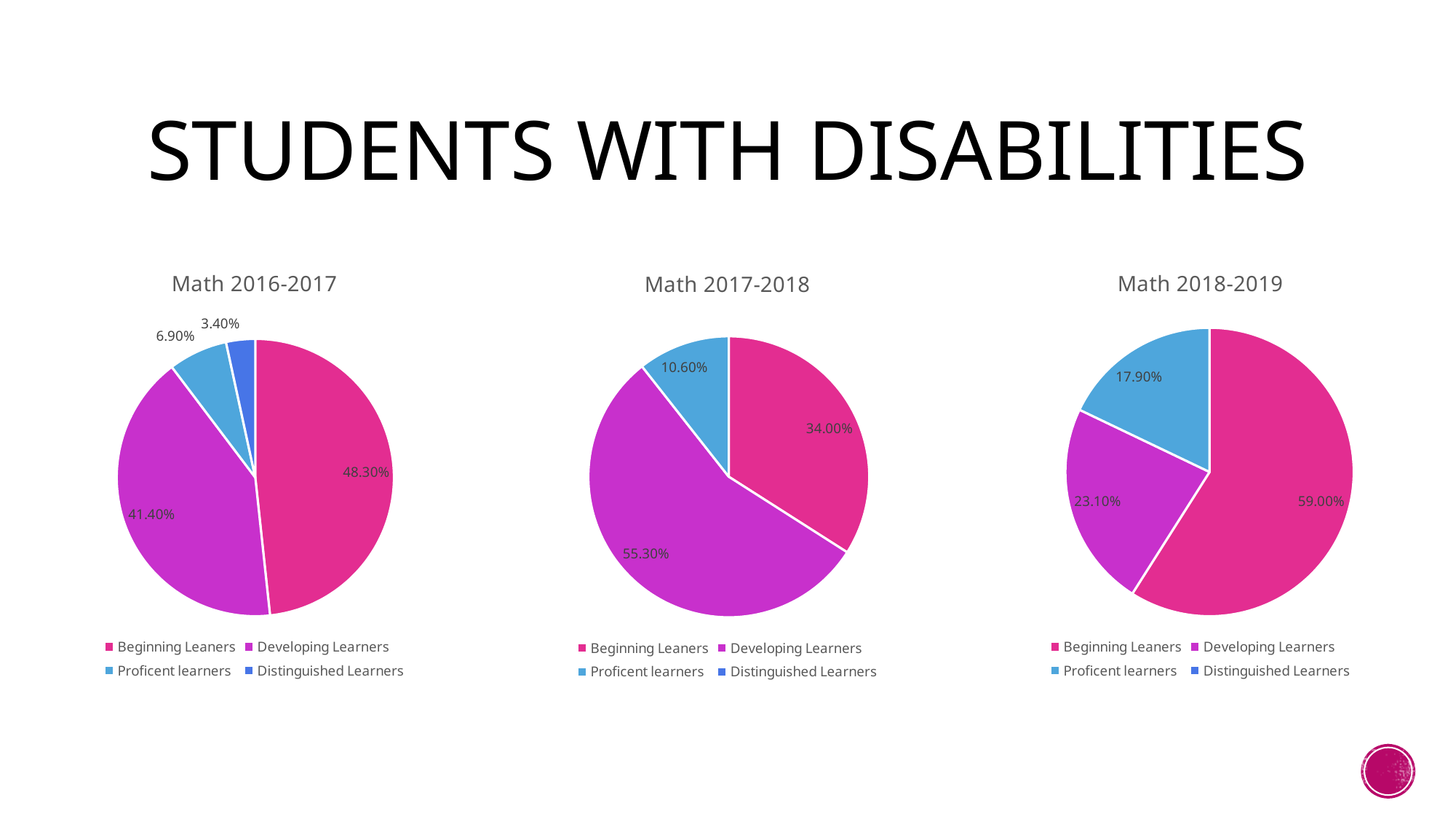
In the Math 2017-2018 chart, what is the value for Developing Learners? 55.30% In the Math 2016-2017 chart, what is the value for Distinguished Learners? 3.40% In the Math 2018-2019 chart, what is the value for Proficent learners? 17.90% How many entries does the legend of the Math 2018-2019 chart list? 4 In the Math 2018-2019 chart, what is the difference between Beginning Leaners and Developing Learners? 35.90% In the Math 2018-2019 chart, which category has the largest slice? Beginning Leaners In the Math 2016-2017 chart, what share of the pie is Beginning Leaners? 48.30% In the Math 2016-2017 chart, which category has the smallest slice? Distinguished Learners What kind of chart is the Math 2017-2018 chart? Pie chart In the Math 2017-2018 chart, which category has the largest slice? Developing Learners In the Math 2017-2018 chart, which is larger, Beginning Leaners or Proficent learners? Beginning Leaners How many slices are shown in the Math 2016-2017 pie chart? 4